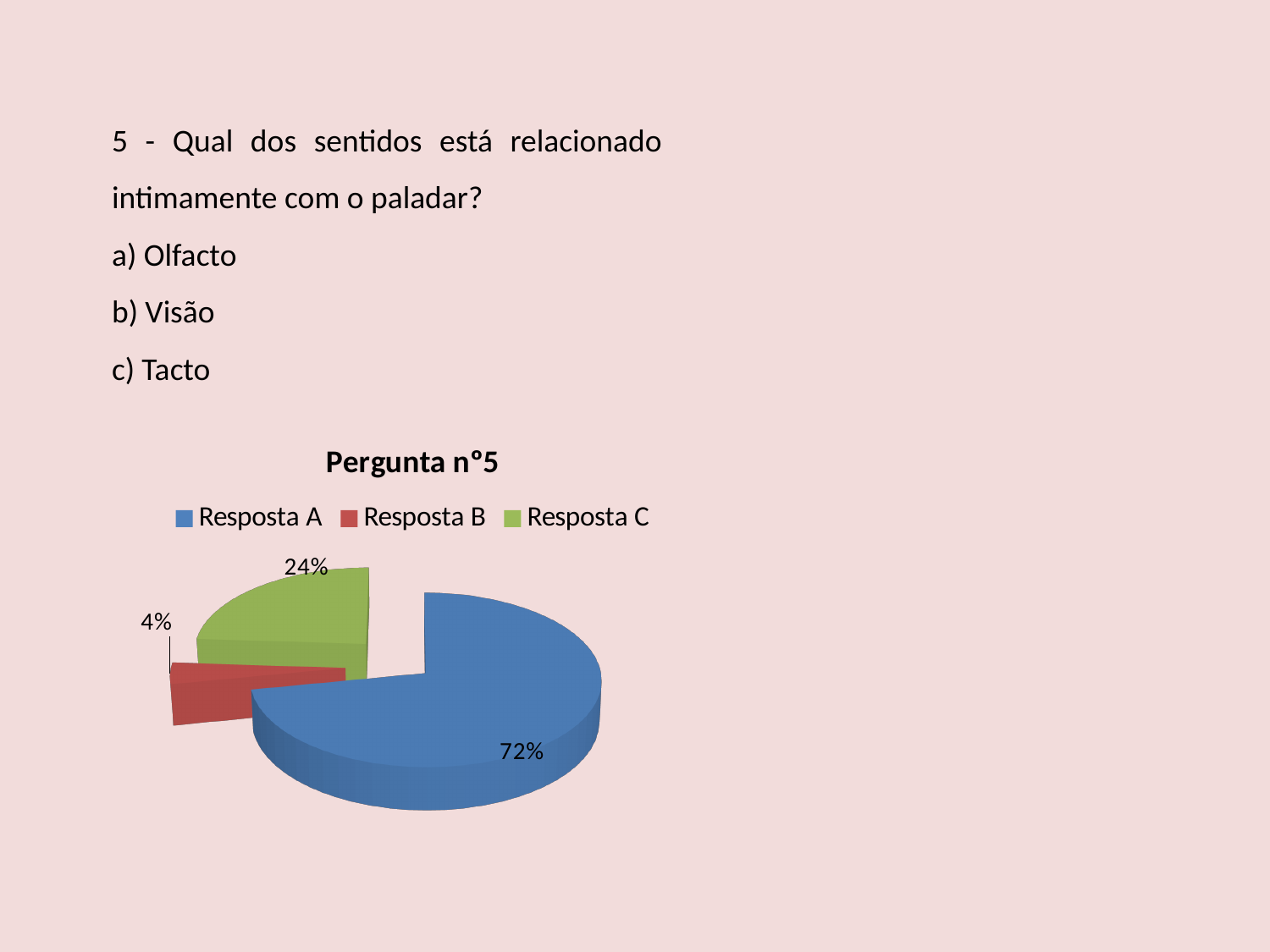
What is the difference in percentage points between Resposta C and Resposta B? 20 Which response has the largest slice of the pie? Resposta A Which response has the smallest slice of the pie? Resposta B What share of the pie does Resposta A have? 72% Which is larger, the slice for Resposta C or the slice for Resposta B? Resposta C What share of the pie does Resposta C have? 24% How many slices does the pie chart have? 3 What is the difference in percentage points between Resposta A and Resposta C? 48 What kind of chart is shown on the slide? Pie chart How many entries does the legend list? 3 What is the title of the chart? Pergunta nº5 What share of the pie does Resposta B have? 4%